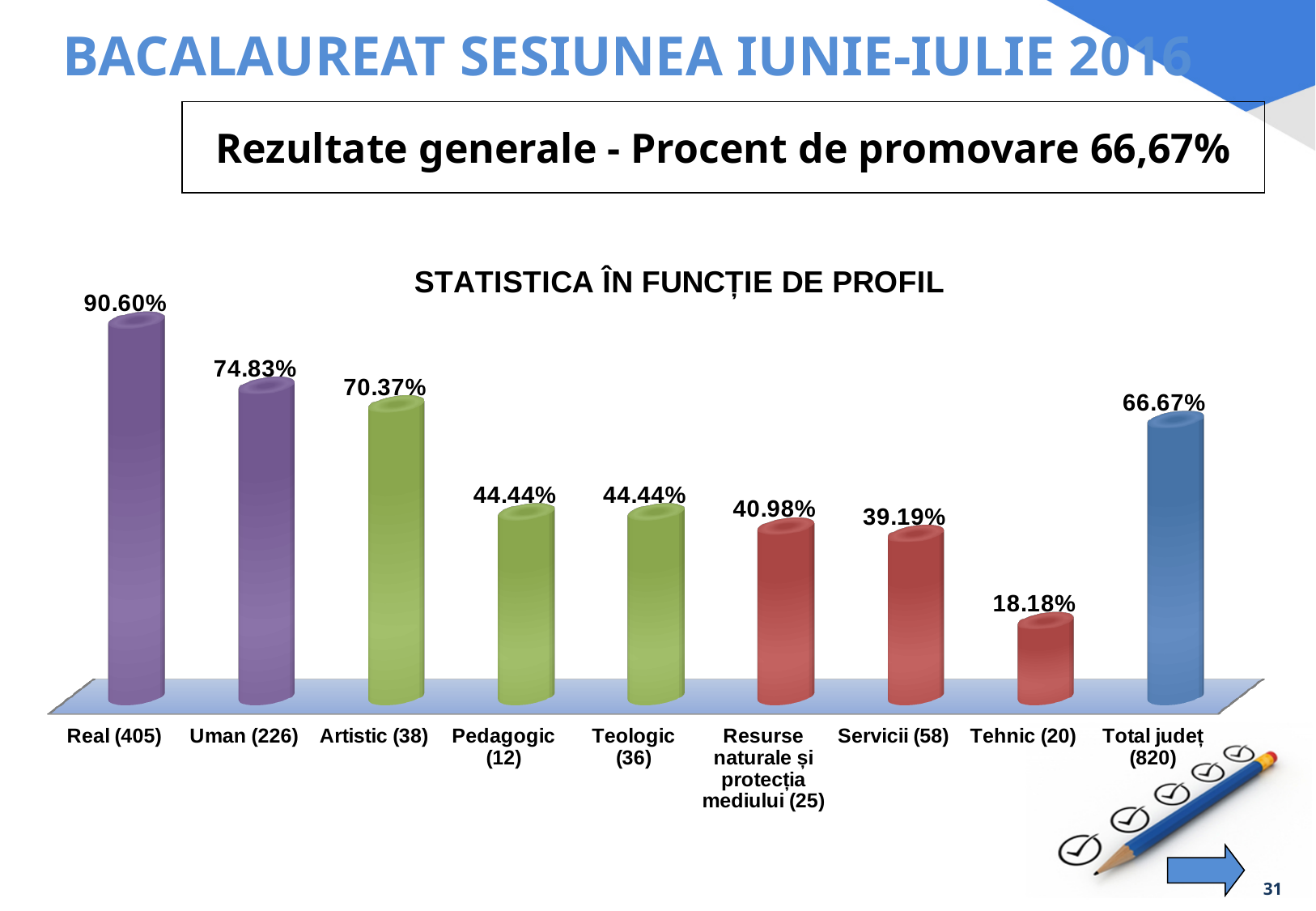
How many categories are plotted in the chart? 9 What is the value for Resurse naturale și protecția mediului (25)? 40.98% What is the value for Tehnic (20)? 18.18% Which is larger, the value for Artistic (38) or the value for Servicii (58)? Artistic (38) What colour are the bars for Real (405) and Uman (226)? Purple Which category has the highest value? Real (405) What is the chart's title? STATISTICA ÎN FUNCȚIE DE PROFIL What is the difference between the values for Real (405) and Uman (226)? 15.77 percentage points What is the value for Real (405)? 90.60% What is the value for Total județ (820)? 66.67% What type of chart is shown on the slide? Bar chart Which category has the lowest value? Tehnic (20)